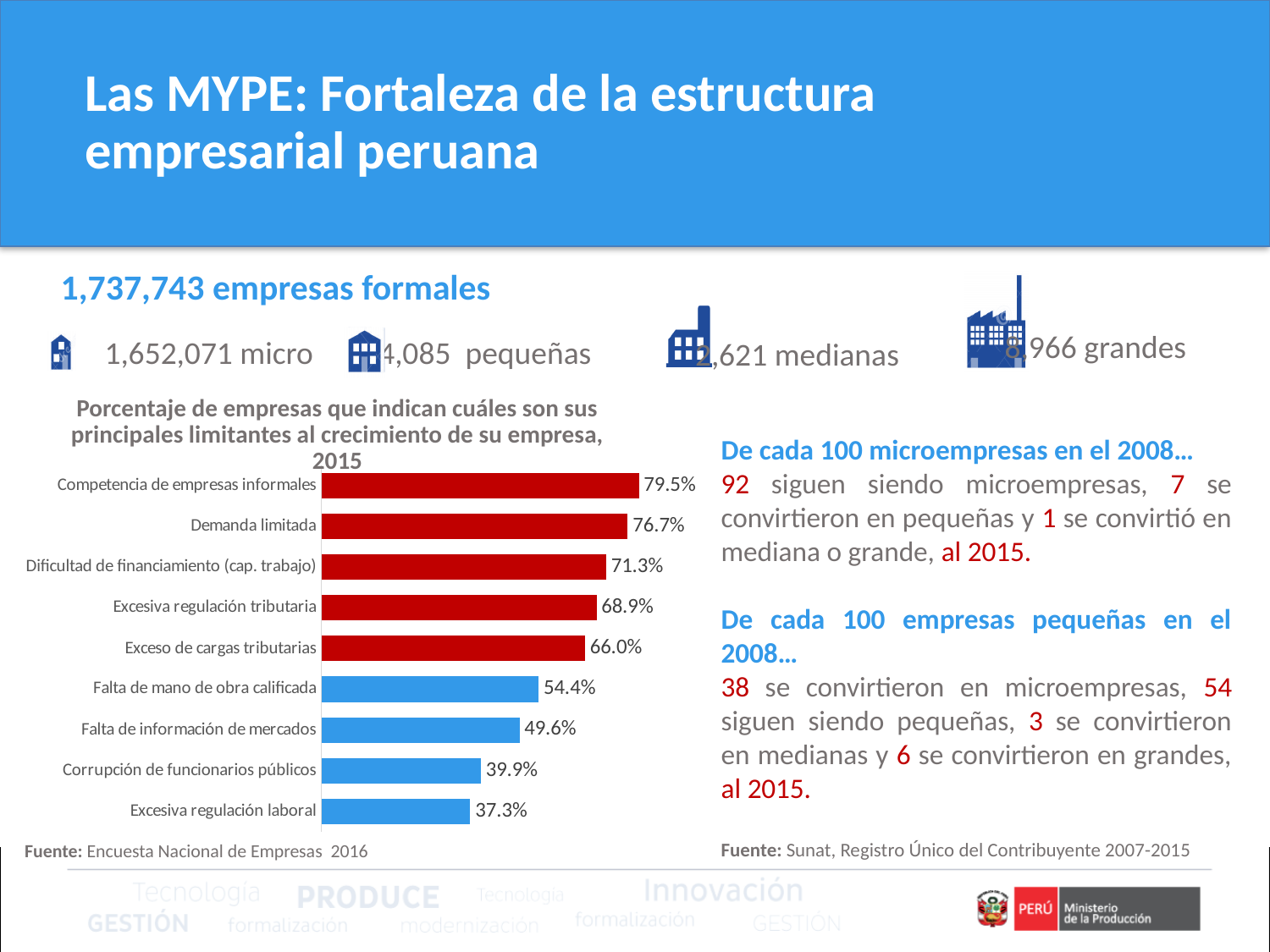
What year does the chart title say the data refers to? 2015 What colour are the bars for the five highest-ranked limitations? Red Which has a larger value: "Exceso de cargas tributarias" or "Falta de información de mercados"? Exceso de cargas tributarias What is the difference in percentage points between "Demanda limitada" and "Dificultad de financiamiento (cap. trabajo)"? 5.4 percentage points What is the difference in percentage points between "Competencia de empresas informales" and "Excesiva regulación laboral"? 42.2 percentage points Which limitation has the lowest percentage in the chart? Excesiva regulación laboral What is the value shown for "Corrupción de funcionarios públicos"? 39.9% Which limitation has the highest percentage in the chart? Competencia de empresas informales What percentage of firms cite "Competencia de empresas informales" as a main limitation to growth? 79.5% How many limitations (categories) are shown in the bar chart? 9 What is the value shown for "Falta de mano de obra calificada"? 54.4% What type of chart is used to show the percentage of firms indicating their main limitations to growth? Bar chart